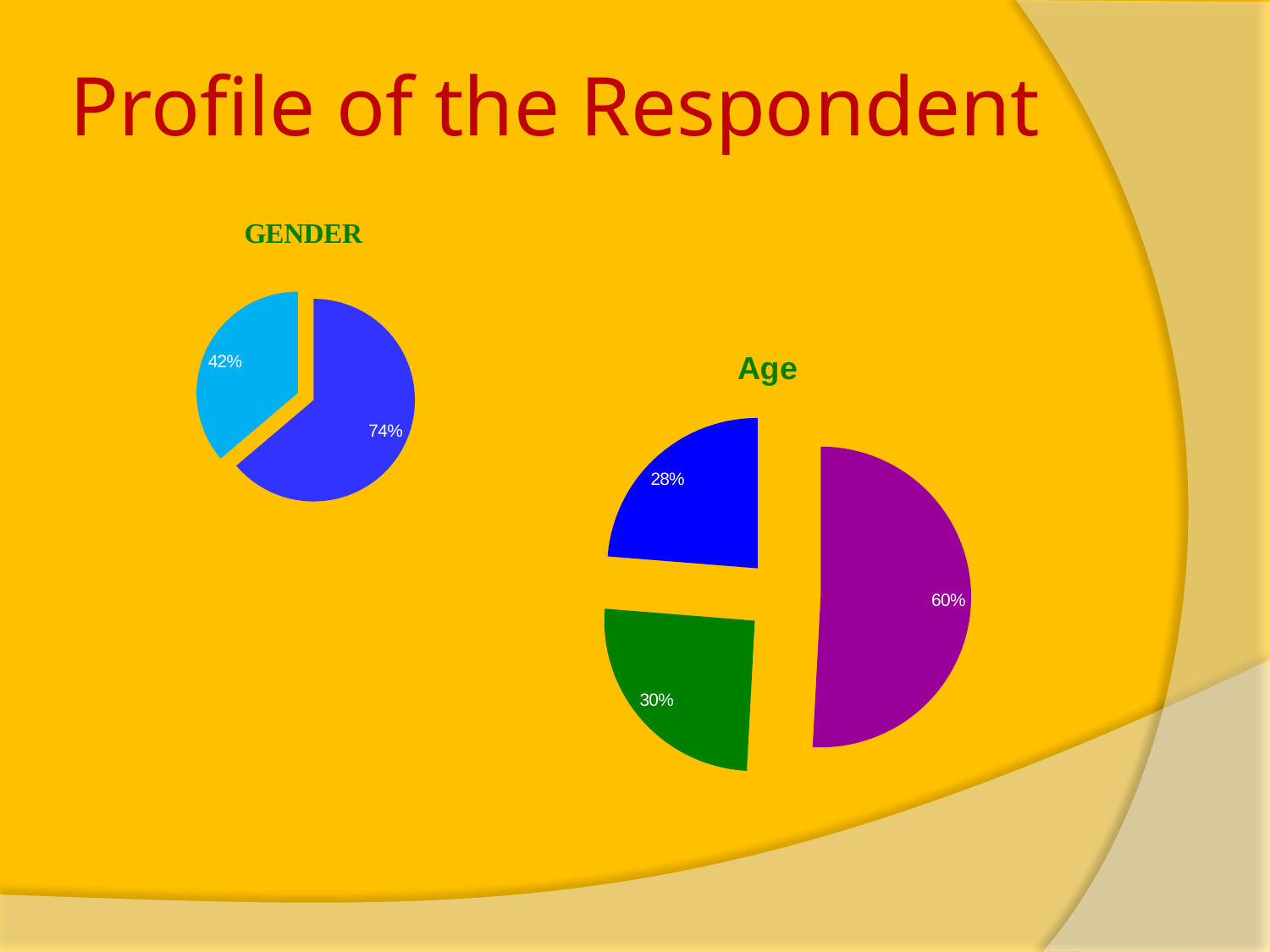
In the GENDER chart, what is the value of the largest slice? 74% What type of chart is the GENDER chart? pie chart In the Age chart, what percentage is shown on the green slice? 30% How many slices does the Age pie chart have? 3 In the Age chart, what is the value of the smallest slice? 28% In the Age chart, what is the difference between the purple slice and the blue slice? 32 percentage points In the Age chart, what percentage is shown on the purple slice? 60% How many slices does the GENDER pie chart have? 2 In the GENDER chart, what percentage is shown on the dark blue slice? 74% What is the title of the pie chart on the left of the slide? GENDER In the GENDER chart, what percentage is shown on the light blue slice? 42% In the Age chart, which slice is larger, the green one or the blue one? the green one